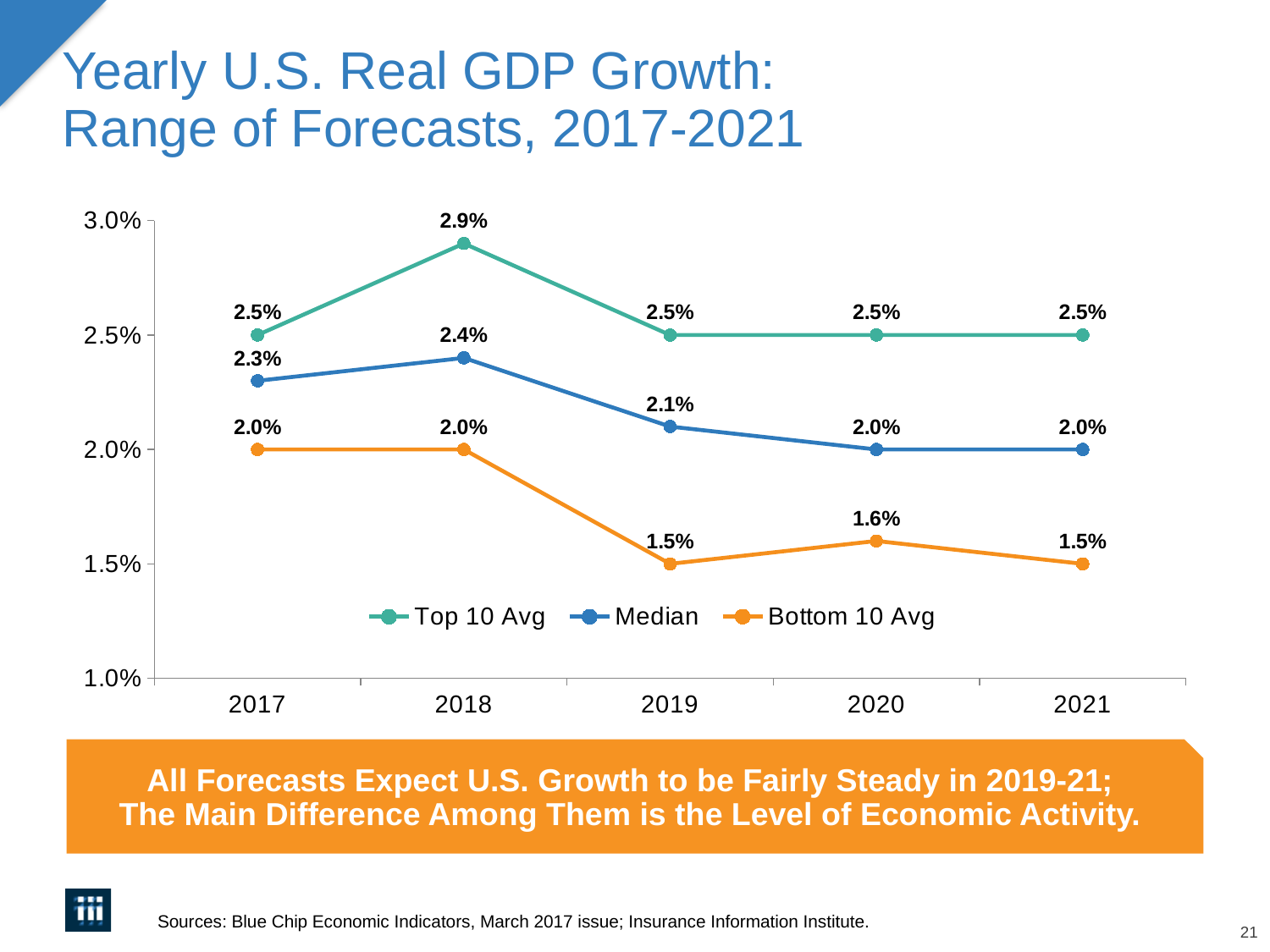
How many series does the legend list? 3 In which year is the Median forecast highest? 2018 Which is larger, the Median forecast for 2017 or the Median forecast for 2020? 2017 How many years are shown on the x axis? 5 What is the Top 10 Avg forecast for 2018? 2.9% What is the difference between the Top 10 Avg and Bottom 10 Avg forecasts for 2019? 1.0% What is the Bottom 10 Avg forecast for 2020? 1.6% Does the Bottom 10 Avg forecast rise or fall from 2018 to 2019? Fall What is the Median forecast for 2019? 2.1% What kind of chart is shown on the slide? Line chart In which year is the Top 10 Avg forecast highest? 2018 What is the difference between the Median forecasts for 2018 and 2021? 0.4%